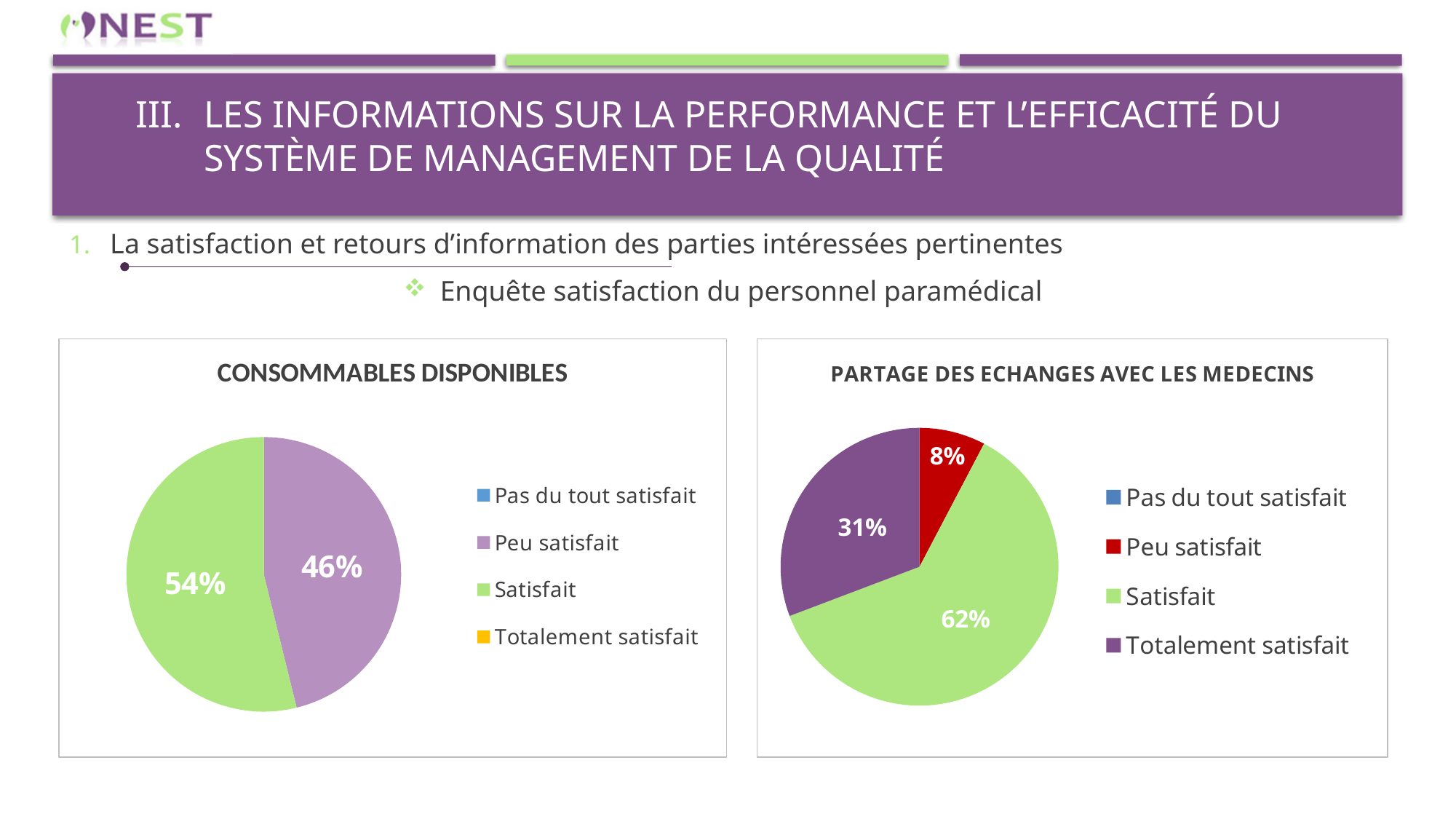
In the 'CONSOMMABLES DISPONIBLES' chart, which category has the largest slice? Satisfait In the 'PARTAGE DES ECHANGES AVEC LES MEDECINS' chart, what colour is the 'Totalement satisfait' slice? Purple In the 'PARTAGE DES ECHANGES AVEC LES MEDECINS' chart, how many slices are shown in the pie? 3 In the 'CONSOMMABLES DISPONIBLES' chart, what is the difference between the 'Satisfait' and 'Peu satisfait' shares? 8% In the 'PARTAGE DES ECHANGES AVEC LES MEDECINS' chart, what share is labelled for 'Satisfait'? 62% In the 'PARTAGE DES ECHANGES AVEC LES MEDECINS' chart, what share is labelled for 'Totalement satisfait'? 31% In the 'PARTAGE DES ECHANGES AVEC LES MEDECINS' chart, what share is labelled for 'Peu satisfait'? 8% In the 'PARTAGE DES ECHANGES AVEC LES MEDECINS' chart, which category has the smallest slice? Peu satisfait What kind of chart is 'CONSOMMABLES DISPONIBLES'? Pie chart How many entries does the legend of the 'CONSOMMABLES DISPONIBLES' chart list? 4 In the 'CONSOMMABLES DISPONIBLES' chart, what share is labelled for 'Satisfait'? 54% In the 'CONSOMMABLES DISPONIBLES' chart, what share is labelled for 'Peu satisfait'? 46%